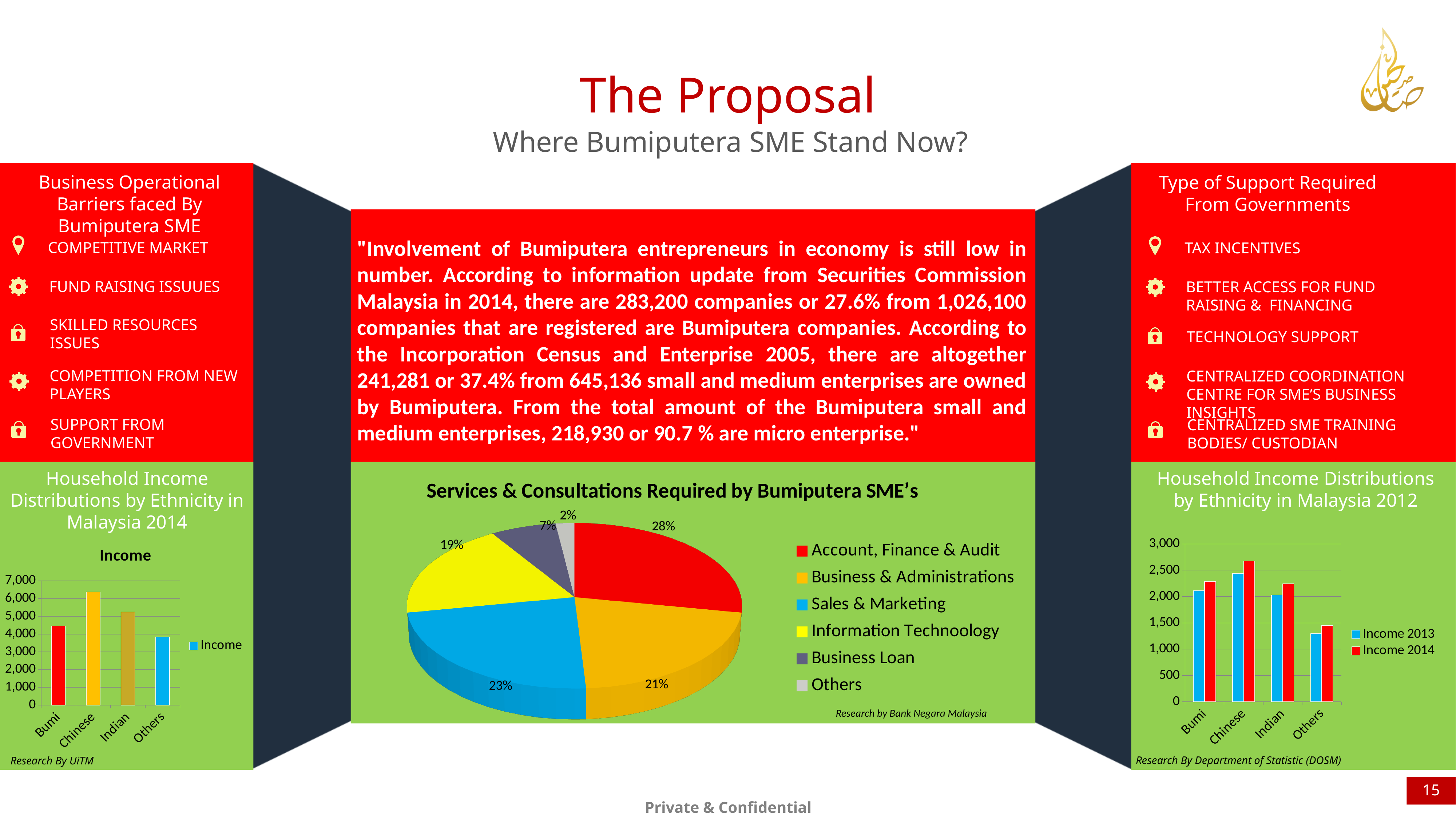
How many series does the legend of the right-hand chart 'Household Income Distributions by Ethnicity in Malaysia 2012' list? 2 How many slices does the pie chart 'Services & Consultations Required by Bumiputera SME's' have? 6 In the right-hand chart 'Household Income Distributions by Ethnicity in Malaysia 2012', is the Income 2014 value for Chinese greater or less than 2,500? greater What kind of chart is the right-hand chart 'Household Income Distributions by Ethnicity in Malaysia 2012'? bar chart In the pie chart 'Services & Consultations Required by Bumiputera SME's', what share is Sales & Marketing? 23% In the pie chart 'Services & Consultations Required by Bumiputera SME's', what share is Account, Finance & Audit? 28% In the 'Income' bar chart on the left (Household Income Distributions by Ethnicity in Malaysia 2014), which ethnicity has the highest income? Chinese In the pie chart 'Services & Consultations Required by Bumiputera SME's', what is the difference between the Information Technoology share and the Business Loan share? 12% In the pie chart 'Services & Consultations Required by Bumiputera SME's', which category has the largest share? Account, Finance & Audit In the pie chart 'Services & Consultations Required by Bumiputera SME's', which category has the smallest share? Others In the 'Income' bar chart on the left (Household Income Distributions by Ethnicity in Malaysia 2014), is the value for Chinese greater or less than 6,000? greater